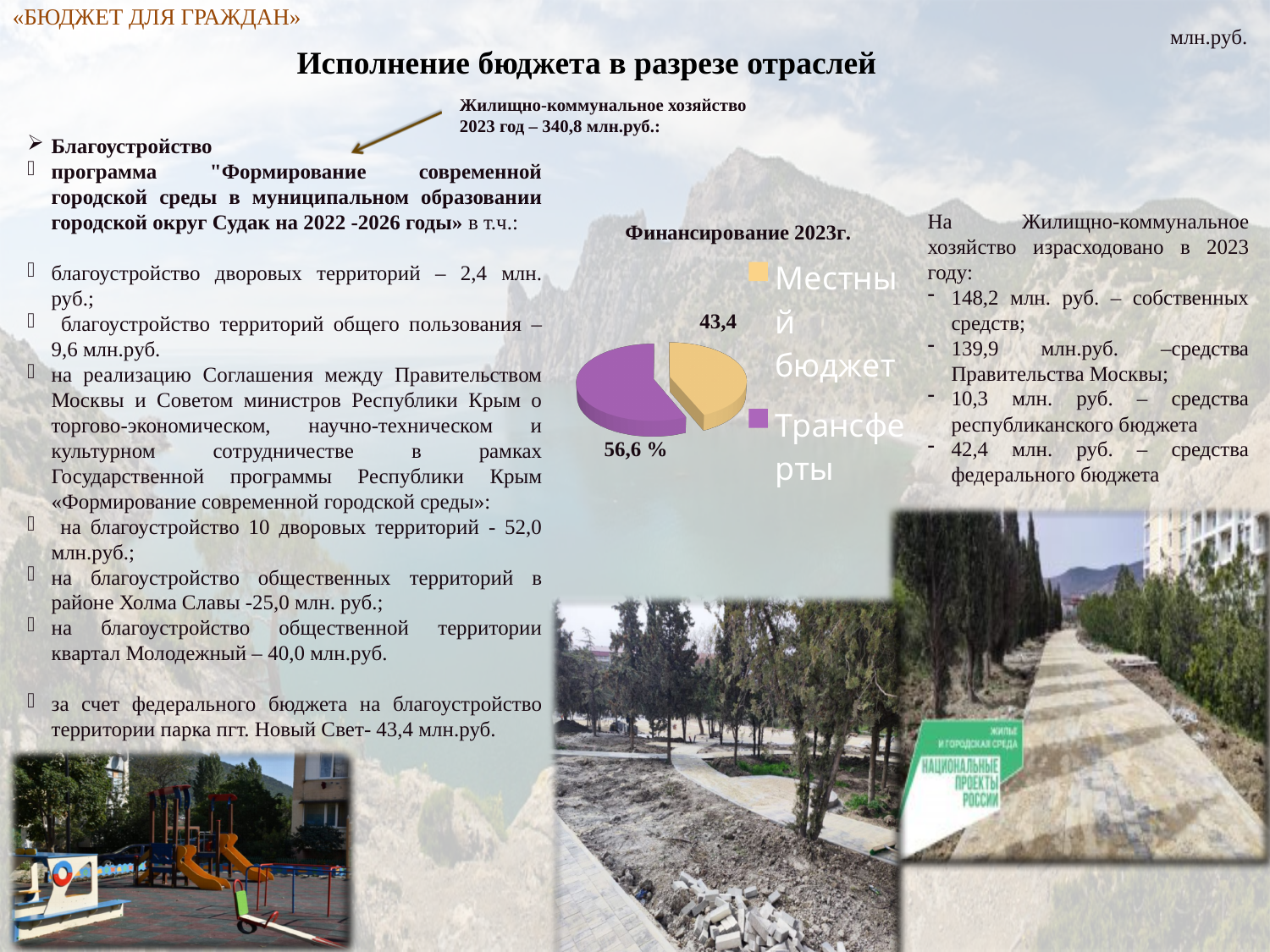
Which slice of the pie chart is the smallest? Местный бюджет What kind of chart is shown under the title "Финансирование 2023г."? pie chart What value is shown for the "Трансферты" slice of the pie chart? 56,6 % Which slice of the pie chart is the largest? Трансферты In the pie chart, which is larger: "Местный бюджет" or "Трансферты"? Трансферты What colour is the "Трансферты" slice in the pie chart? purple What is the title of the pie chart on the slide? Финансирование 2023г. How many slices does the pie chart have? 2 What value is shown for the "Местный бюджет" slice of the pie chart? 43,4 How many entries does the legend of the pie chart list? 2